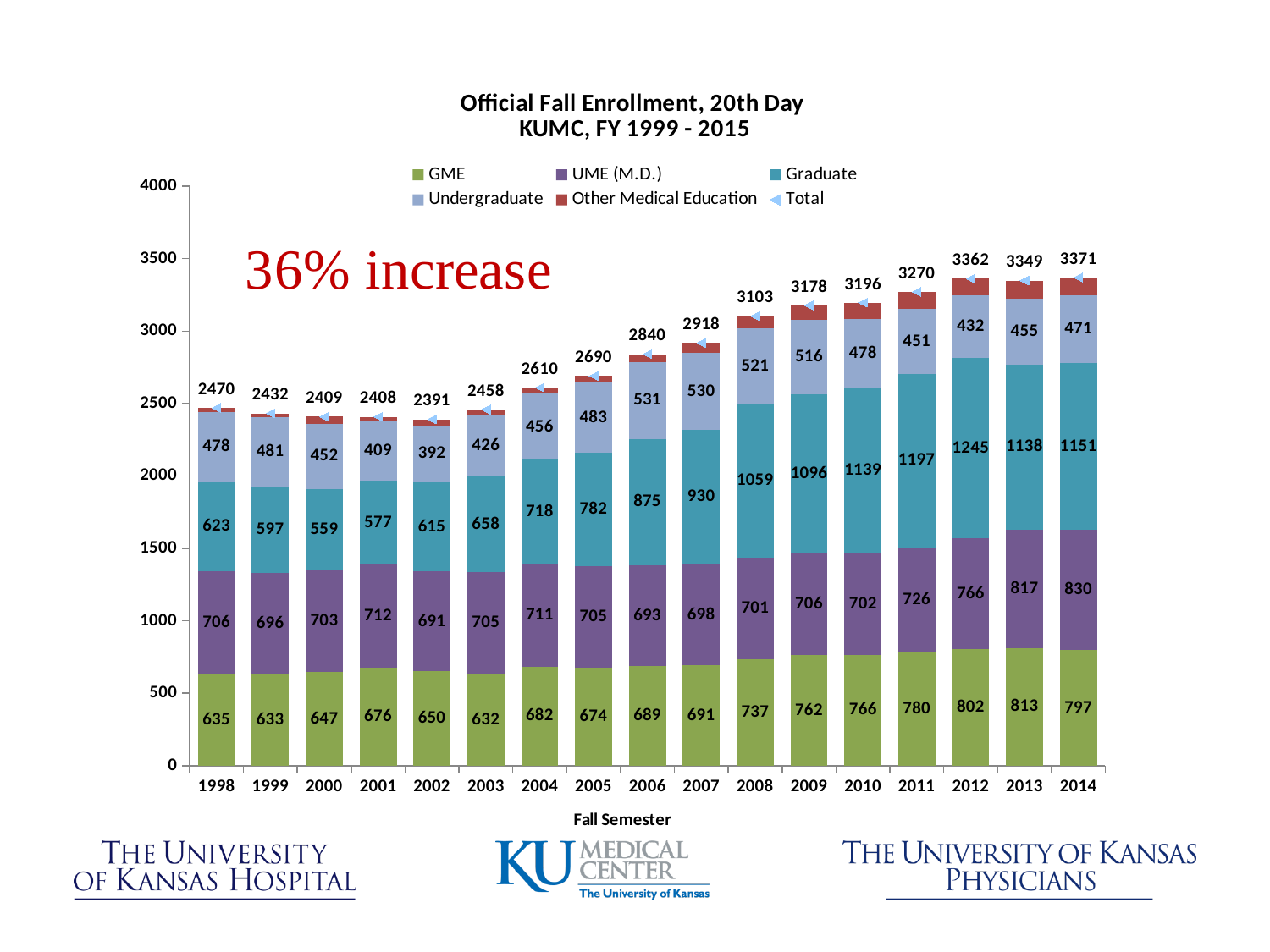
Does the Graduate enrollment rise or fall from 2003 to 2012? Rise What is the Undergraduate enrollment value for 2002? 392 What is the Total enrollment shown for 2008? 3103 Which year has the larger GME enrollment, 2013 or 2014? 2013 Which year has the highest Graduate enrollment? 2012 Which year has the lowest Total enrollment? 2002 What kind of chart is shown on the slide? Stacked bar chart What is the difference between the Total enrollment in 2014 and in 1998? 901 Which year has the highest Total enrollment? 2014 How many entries does the legend list? 6 What is the Graduate enrollment value for 2012? 1245 How many years are shown on the x axis? 17